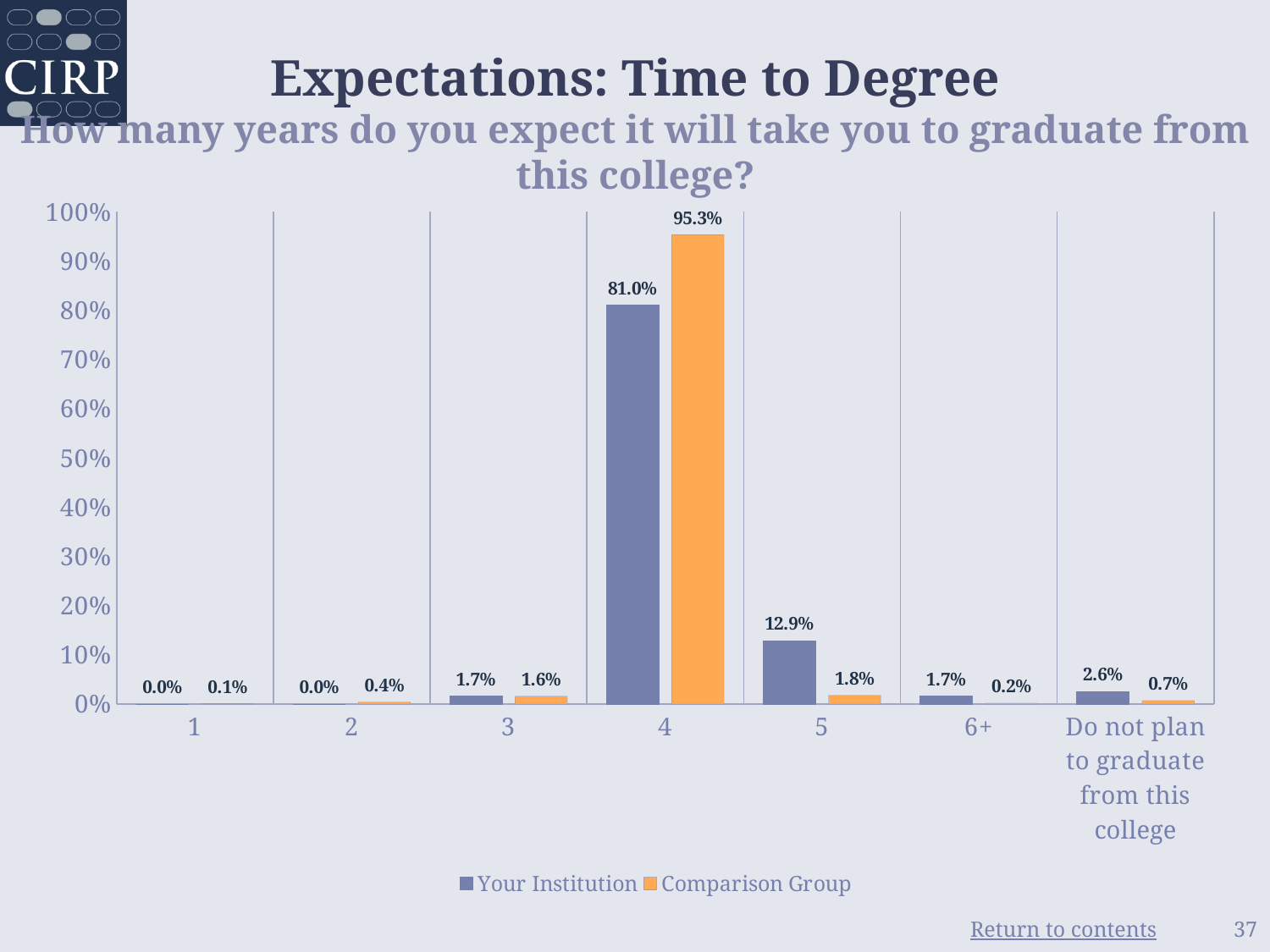
How many categories are shown on the x axis? 7 What is the value for Comparison Group for the category 'Do not plan to graduate from this college'? 0.7% How many series does the legend list? 2 What is the value for Your Institution for the category 4? 81.0% What kind of chart is shown on the slide? Bar chart What is the difference between the Comparison Group and Your Institution values for the category 4? 14.3% For the category 5, which series has the larger value, Your Institution or Comparison Group? Your Institution Which category has the lowest value for Comparison Group? 1 Is the value for Your Institution for the category 4 greater or less than 80%? greater What is the value for Your Institution for the category 5? 12.9% Which category has the highest value for Your Institution? 4 What is the value for Comparison Group for the category 4? 95.3%